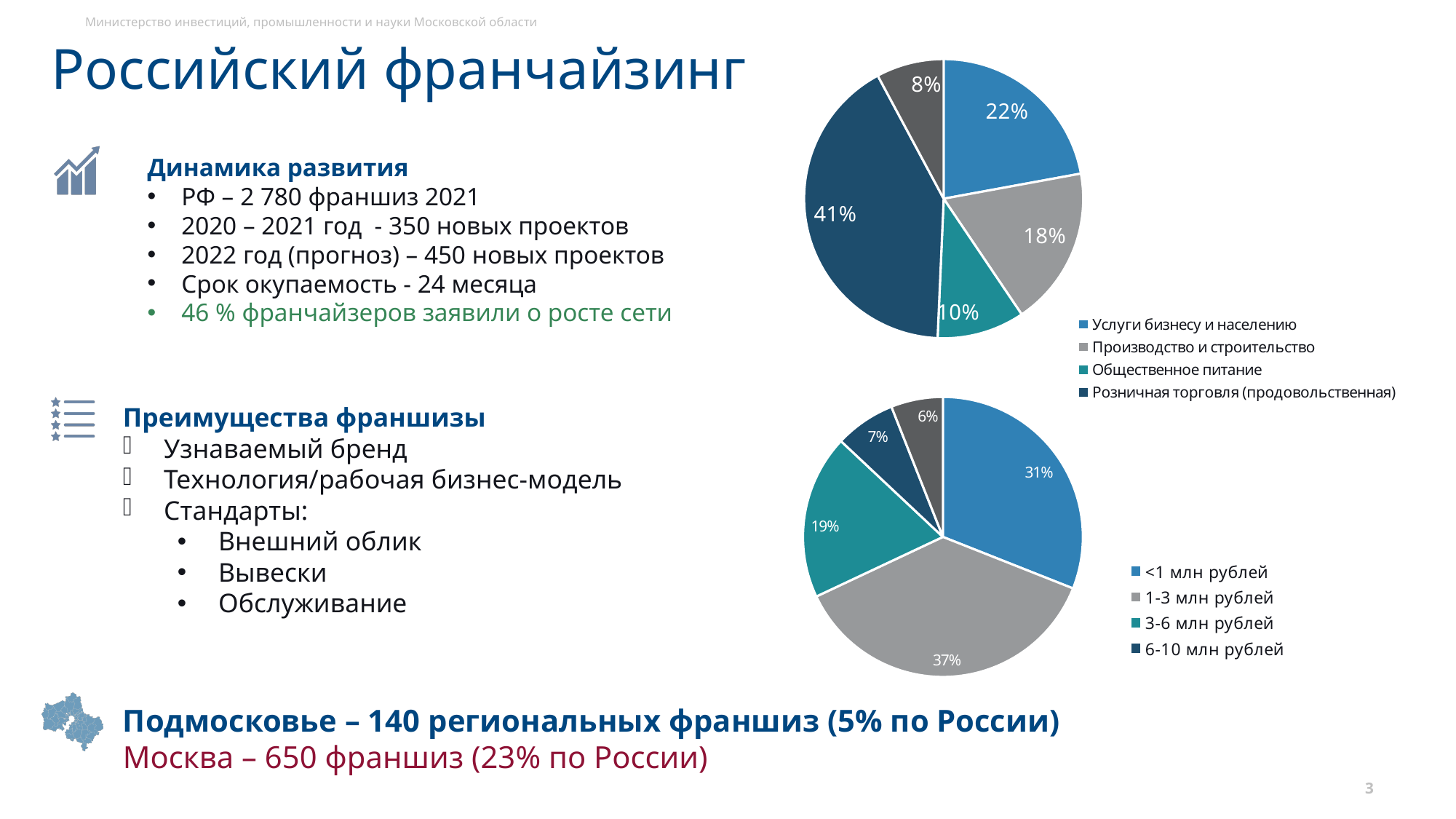
In the bottom pie chart, what is the difference between the shares of 1-3 млн рублей and <1 млн рублей? 6% In the top pie chart, what share does Общественное питание have? 10% In the top pie chart, what is the difference between the shares of Услуги бизнесу и населению and Производство и строительство? 4% In the top pie chart, what share does Розничная торговля (продовольственная) have? 41% How many entries does the legend of the top pie chart list? 4 In the bottom pie chart, what share does the 6-10 млн рублей category have? 7% In the bottom pie chart, which legend category has the smallest share? 6-10 млн рублей How many slices does the bottom pie chart have? 5 In the bottom pie chart, what share does the 1-3 млн рублей category have? 37% In the bottom pie chart, which is larger: the share for <1 млн рублей or the share for 3-6 млн рублей? <1 млн рублей What type of chart is the top chart on the right side of the slide? pie chart In the top pie chart, which legend category has the largest share? Розничная торговля (продовольственная)